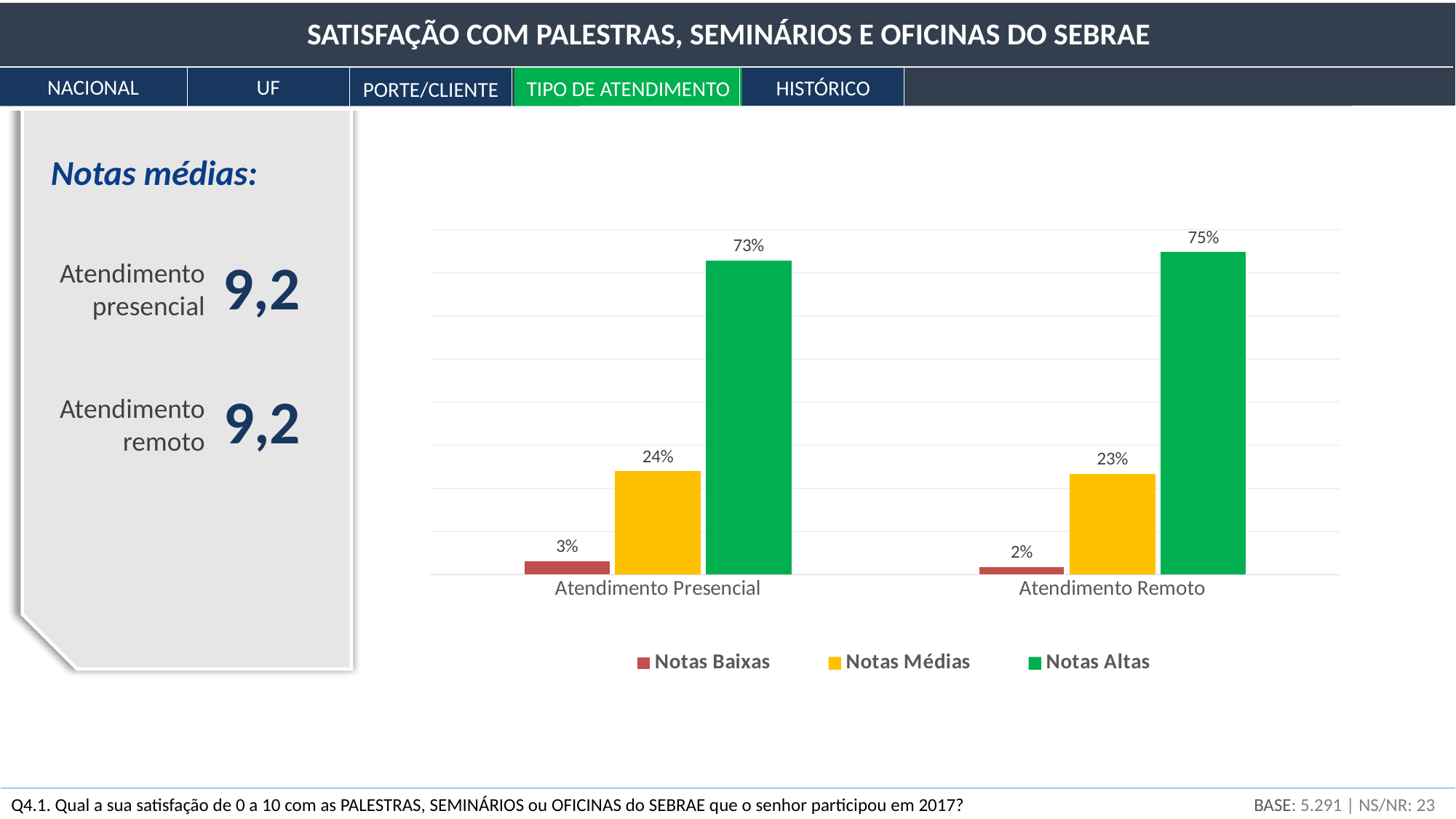
What colour represents Notas Altas in the chart? Green Which series has the lowest value for Atendimento Presencial? Notas Baixas What is the value of Notas Médias for Atendimento Presencial? 24% Which is larger: Notas Médias for Atendimento Presencial or Notas Médias for Atendimento Remoto? Atendimento Presencial What is the value of Notas Altas for Atendimento Presencial? 73% How many categories are shown on the x axis of the chart? 2 How many series does the chart legend list? 3 What is the value of Notas Altas for Atendimento Remoto? 75% Which series has the highest value for Atendimento Remoto? Notas Altas What is the difference between Notas Altas for Atendimento Remoto and Notas Altas for Atendimento Presencial? 2% What is the value of Notas Baixas for Atendimento Remoto? 2% What kind of chart is shown on the slide? Bar chart